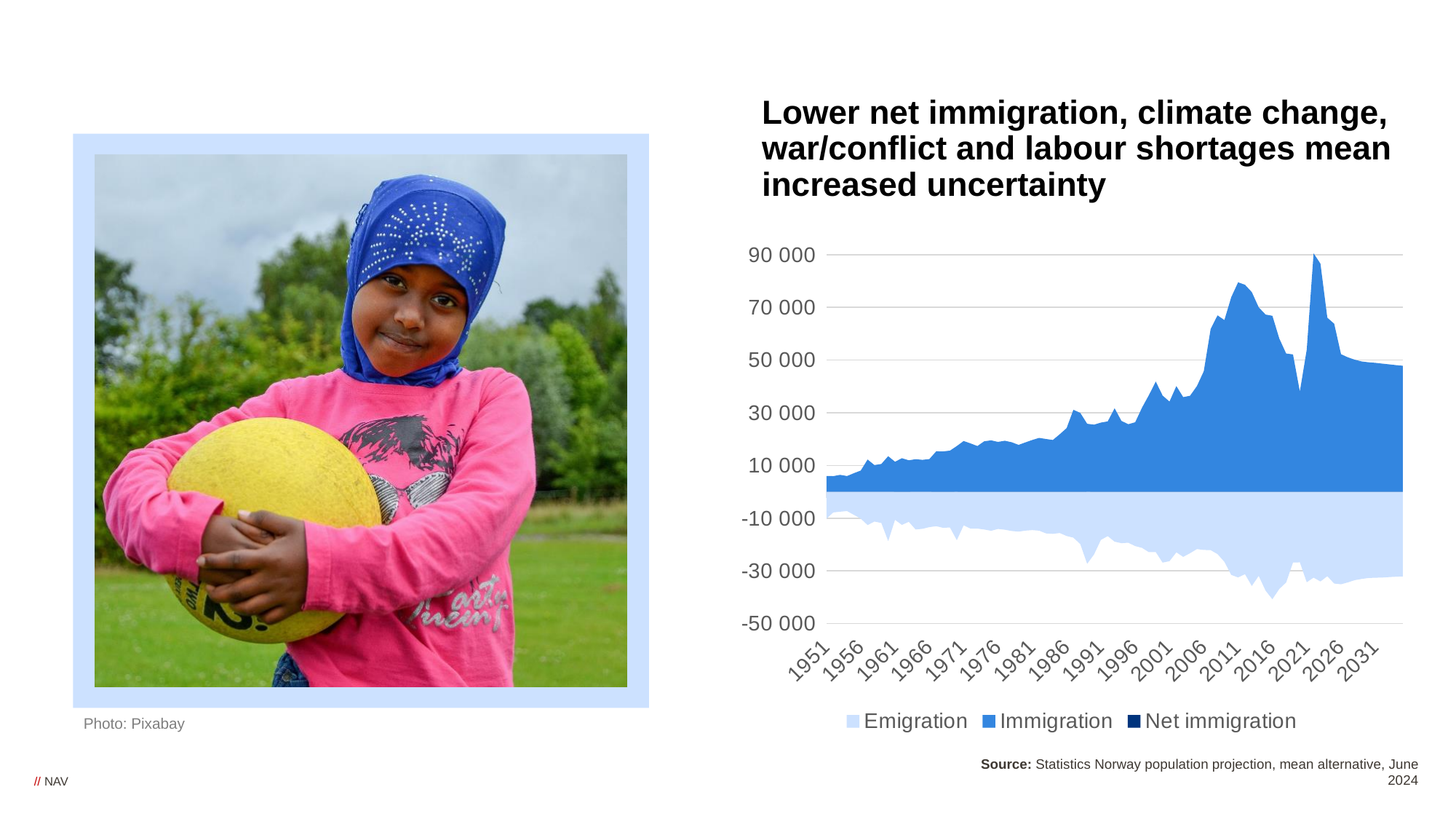
Is the immigration value around 2011 greater or less than 50 000? greater Which immigration peak is higher: the one around 2011 or the one shortly after 2021? Shortly after 2021 Which series are listed in the chart legend? Emigration, Immigration, Net immigration Which is larger: the immigration value in 1951 or the immigration value in 2011? 2011 Does immigration generally rise or fall between 1951 and 2011? Rise How many series does the chart legend list? 3 Is the immigration value in 1951 greater or less than 10 000? less Is the emigration value around 2016 greater or less than -30 000? less How many year labels are shown on the x axis of the chart? 17 What kind of chart is shown on the slide? Area chart What is the title above the chart? Lower net immigration, climate change, war/conflict and labour shortages mean increased uncertainty